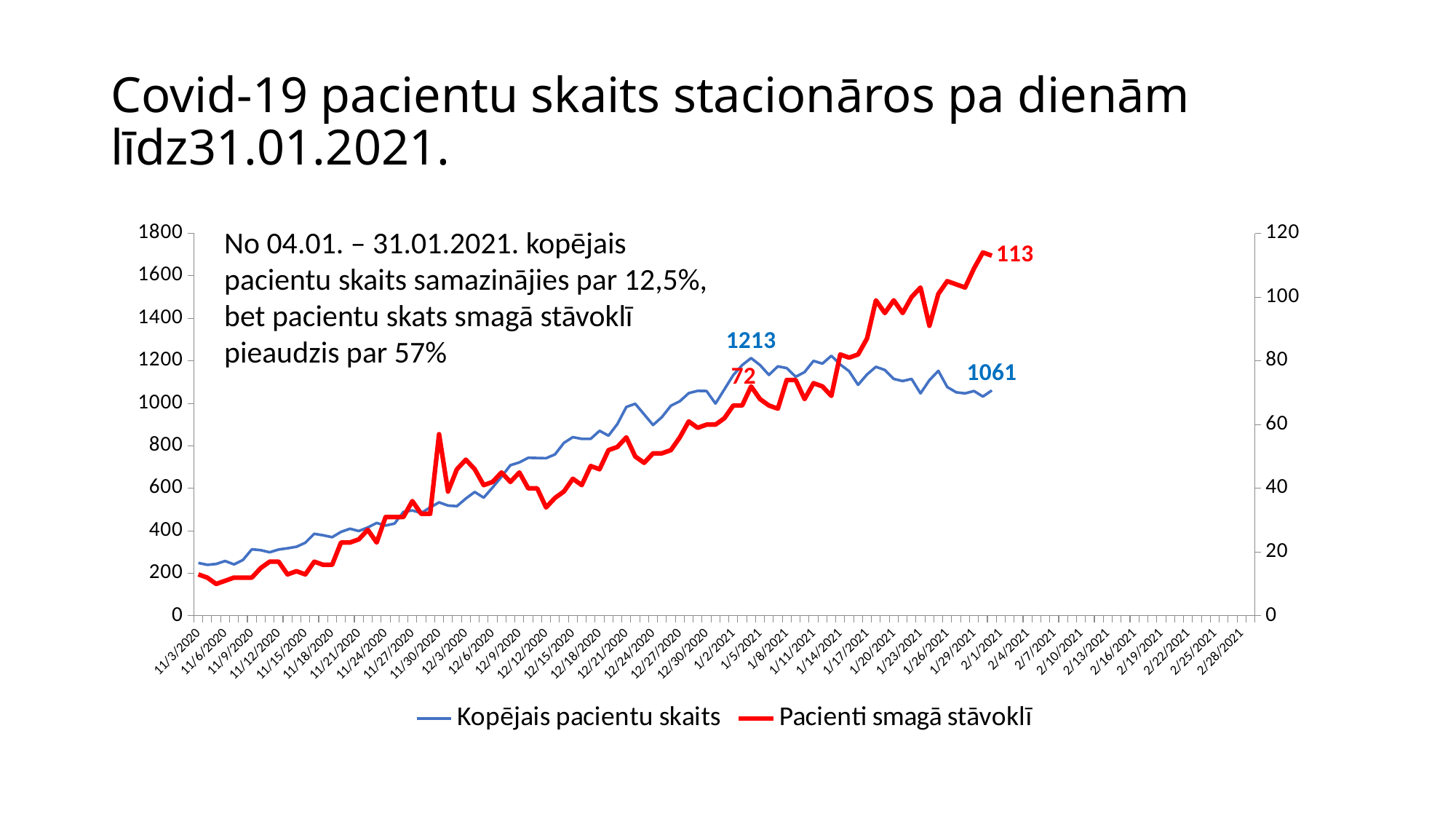
Which labelled value on the 'Kopējais pacientu skaits' line is larger, 1213 or 1061? 1213 Is the value of 'Kopējais pacientu skaits' on 11/3/2020 greater or less than 400? less What is the difference between the two labelled values on the 'Pacienti smagā stāvoklī' line, 113 and 72? 41 Which series is drawn in red? Pacienti smagā stāvoklī What is the last labelled value of the 'Kopējais pacientu skaits' series? 1061 Does the 'Pacienti smagā stāvoklī' series generally rise or fall from 11/3/2020 to the end of January 2021? rise What is the difference between the two labelled values on the 'Kopējais pacientu skaits' line, 1213 and 1061? 152 What kind of chart is shown on the slide? line chart What is the earlier labelled value on the 'Kopējais pacientu skaits' line, near 1/4/2021? 1213 How many series does the legend list? 2 What is the last labelled value of the 'Pacienti smagā stāvoklī' series? 113 What is the earlier labelled value on the 'Pacienti smagā stāvoklī' line, near 1/4/2021? 72